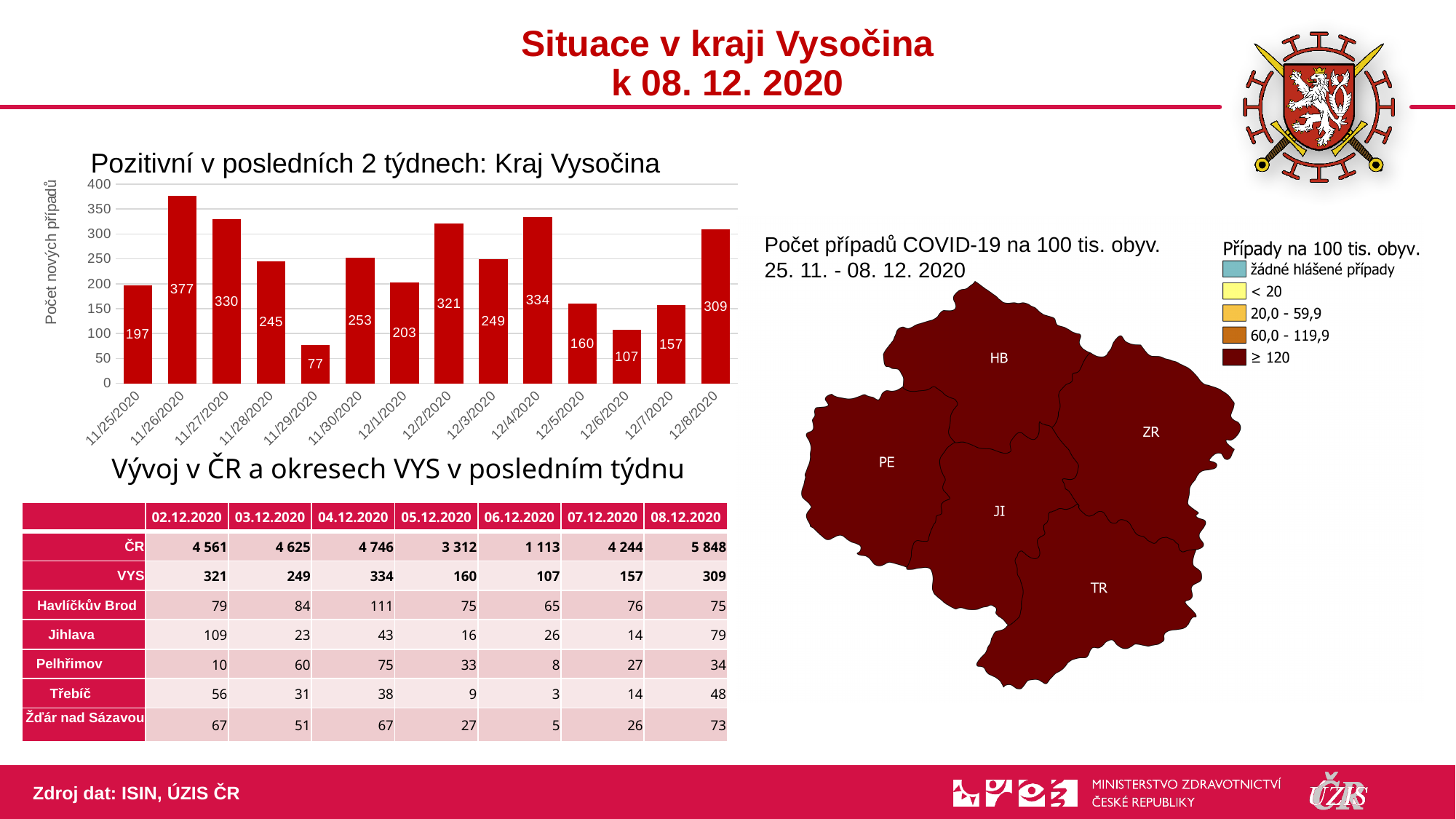
In the chart 'Pozitivní v posledních 2 týdnech: Kraj Vysočina', what is the difference between the values for 11/26/2020 and 11/29/2020? 300 How many dates are shown on the x axis of the chart 'Pozitivní v posledních 2 týdnech: Kraj Vysočina'? 14 In the chart 'Pozitivní v posledních 2 týdnech: Kraj Vysočina', which is larger, the value for 12/5/2020 or 12/6/2020? 12/5/2020 In the chart 'Pozitivní v posledních 2 týdnech: Kraj Vysočina', do the values rise or fall from 12/4/2020 to 12/6/2020? fall In the chart 'Pozitivní v posledních 2 týdnech: Kraj Vysočina', what is the value for 11/26/2020? 377 In the chart 'Pozitivní v posledních 2 týdnech: Kraj Vysočina', what is the difference between the values for 12/8/2020 and 12/7/2020? 152 In the chart 'Pozitivní v posledních 2 týdnech: Kraj Vysočina', which date has the highest value? 11/26/2020 What type of chart is 'Pozitivní v posledních 2 týdnech: Kraj Vysočina'? bar chart In the chart 'Pozitivní v posledních 2 týdnech: Kraj Vysočina', which date has the lowest value? 11/29/2020 In the chart 'Pozitivní v posledních 2 týdnech: Kraj Vysočina', is the value for 11/26/2020 greater or less than 350? greater In the chart 'Pozitivní v posledních 2 týdnech: Kraj Vysočina', what is the value for 11/30/2020? 253 In the chart 'Pozitivní v posledních 2 týdnech: Kraj Vysočina', what is the value for 12/8/2020? 309